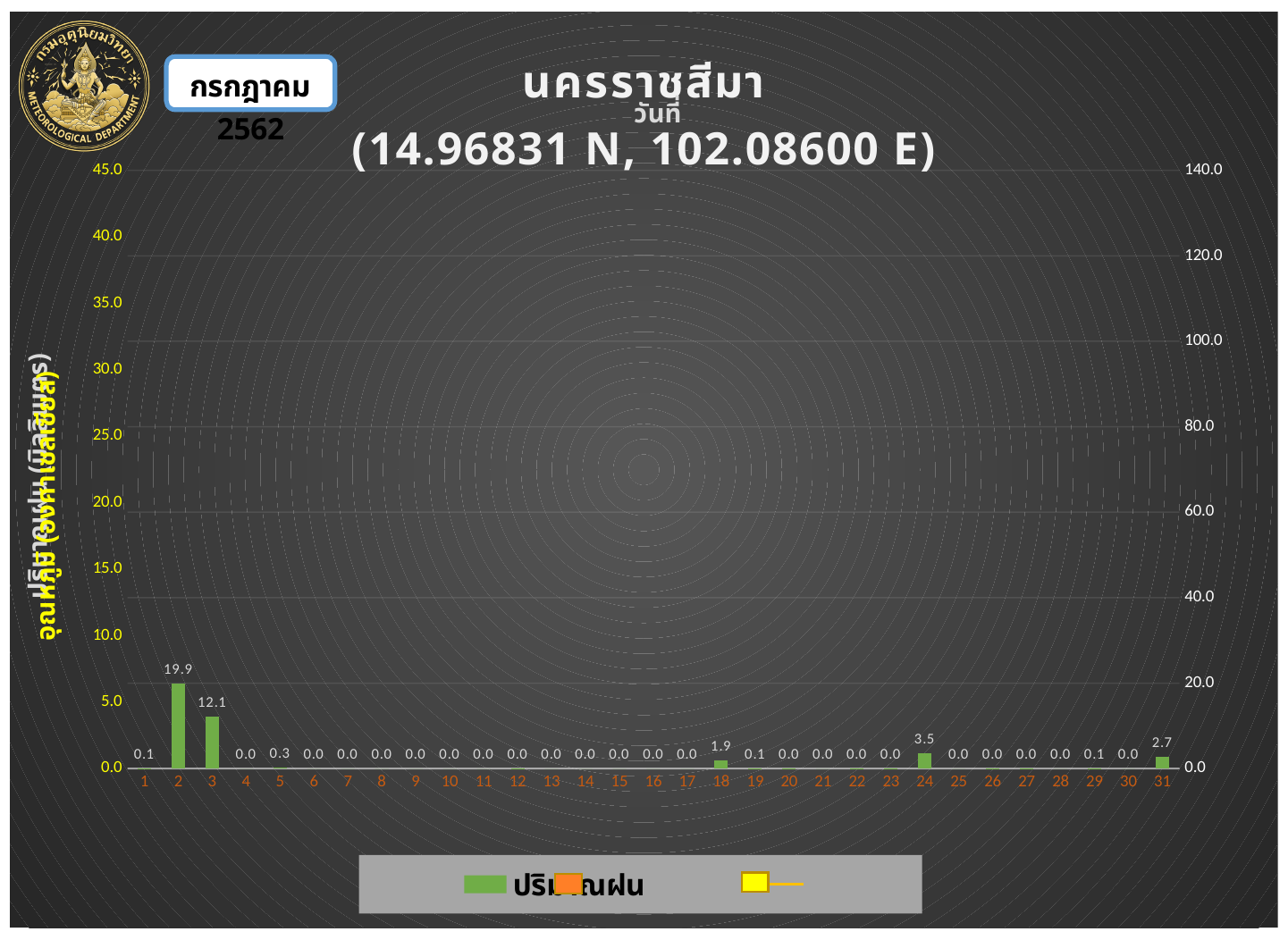
What is the rainfall value labelled for day 2? 19.9 Which day has the highest rainfall value? 2 What is the rainfall value labelled for day 5? 0.3 What is the rainfall value labelled for day 3? 12.1 Which day has the larger rainfall value, day 24 or day 31? 24 What is the rainfall value labelled for day 24? 3.5 How many days are shown on the x axis? 31 What is the rainfall value labelled for day 31? 2.7 What is the difference between the rainfall values for day 24 and day 18? 1.6 What is the difference between the rainfall values for day 2 and day 3? 7.8 What is the rainfall value labelled for day 18? 1.9 What kind of chart is shown on the slide? bar chart